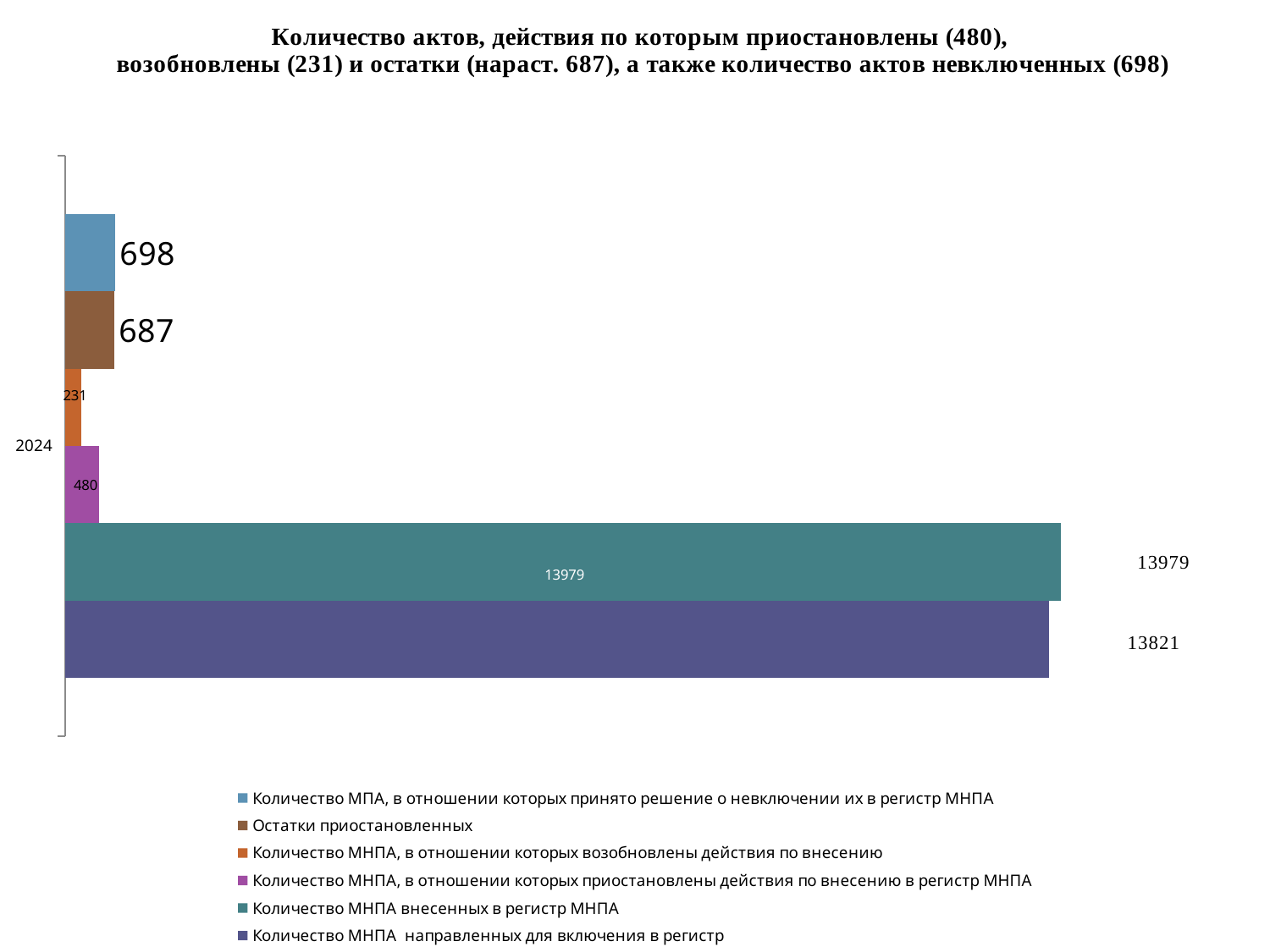
What is the value for "Количество МНПА внесенных в регистр МНПА" in 2024? 13979 What is the value for "Количество МНПА направленных для включения в регистр" in 2024? 13821 What is the difference between the values for "Количество МНПА внесенных в регистр МНПА" and "Количество МНПА направленных для включения в регистр"? 158 How many series does the legend list? 6 Which series has the lowest value in 2024? Количество МНПА, в отношении которых возобновлены действия по внесению What colour is the bar for "Количество МНПА внесенных в регистр МНПА"? teal What type of chart is shown on the slide? bar chart How many categories are shown on the vertical axis? 1 What is the value for "Остатки приостановленных" in 2024? 687 What is the value for "Количество МНПА, в отношении которых возобновлены действия по внесению" in 2024? 231 Which series has the highest value in 2024? Количество МНПА внесенных в регистр МНПА Which is larger: the value for "Количество МНПА, в отношении которых приостановлены действия по внесению в регистр МНПА" or the value for "Количество МНПА, в отношении которых возобновлены действия по внесению"? Количество МНПА, в отношении которых приостановлены действия по внесению в регистр МНПА